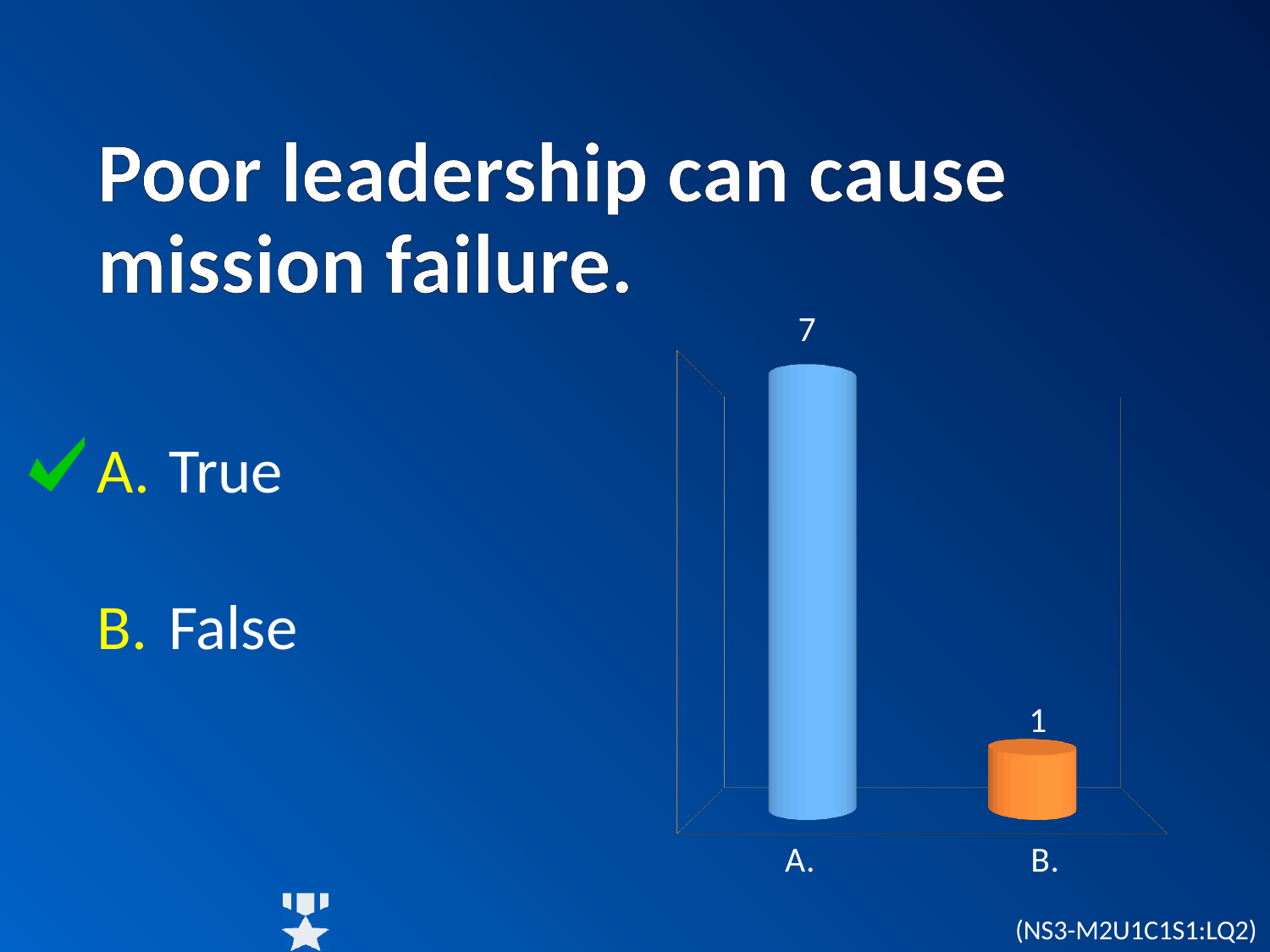
What is the value for category B. in the chart? 1 What is the value for category A. in the chart? 7 What colour is the bar for category A.? Blue Do the values rise or fall from A. to B.? Fall How many categories are shown in the chart? 2 What is the total of the values for A. and B.? 8 What is the difference between the values for A. and B.? 6 What colour is the bar for category B.? Orange Which category has the lowest value in the chart? B. What kind of chart is shown on the slide? Bar chart Which is larger, the value for A. or the value for B.? A. Which category has the highest value in the chart? A.